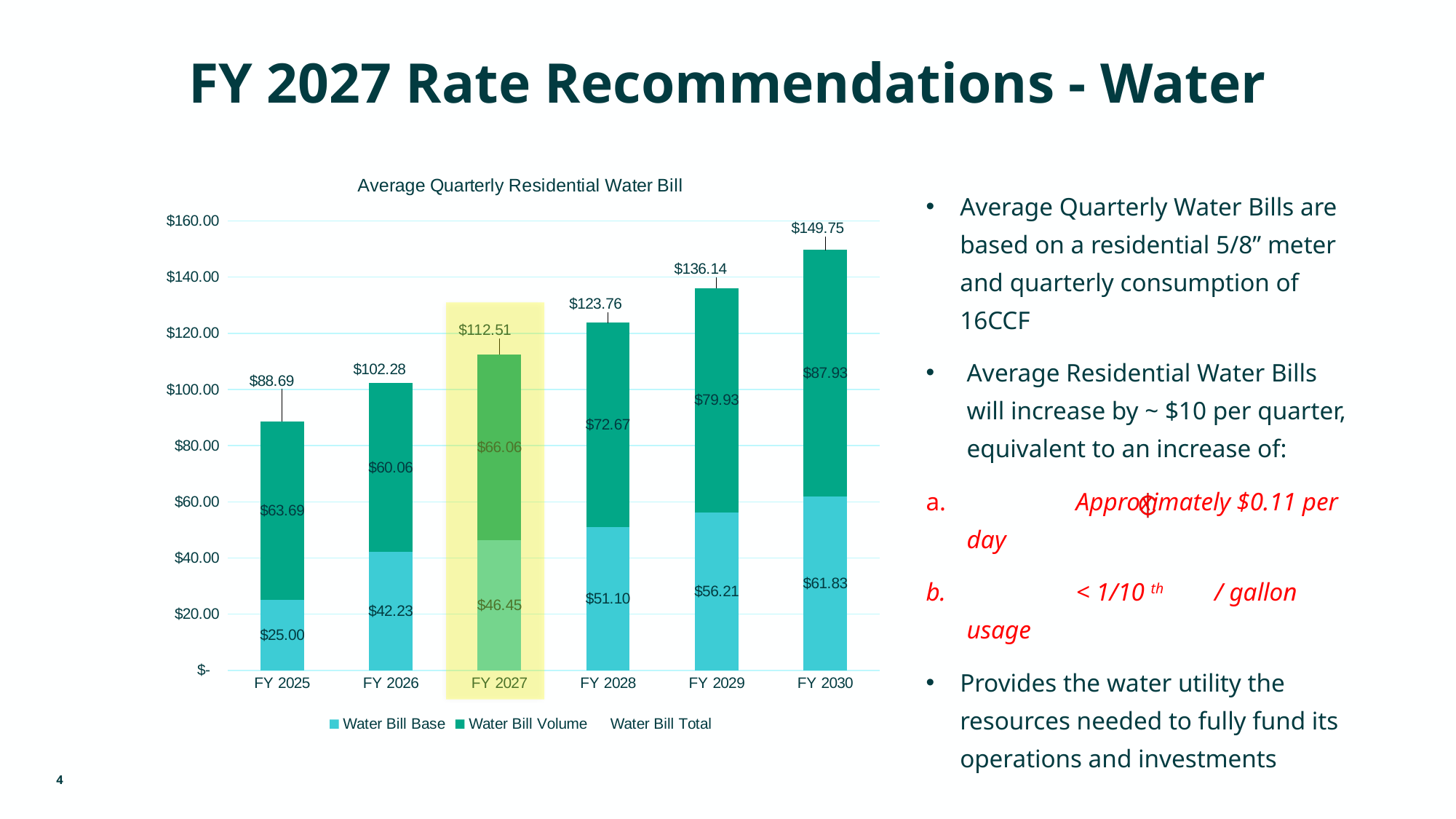
What is the total average quarterly water bill for FY 2027? $112.51 What type of chart is shown on the slide? Stacked bar chart Do the total water bill values rise or fall from FY 2025 to FY 2030? Rise What is the title of the chart? Average Quarterly Residential Water Bill What is the difference between the total water bill for FY 2030 and FY 2025? $61.06 Which fiscal year has the lowest Water Bill Base value? FY 2025 Which fiscal year has the highest total water bill? FY 2030 Which is larger, the Water Bill Volume for FY 2026 or for FY 2028? FY 2028 How many series does the chart legend list? 3 What is the Water Bill Base value for FY 2025? $25.00 How many fiscal years are shown on the x axis? 6 What is the Water Bill Volume value for FY 2029? $79.93